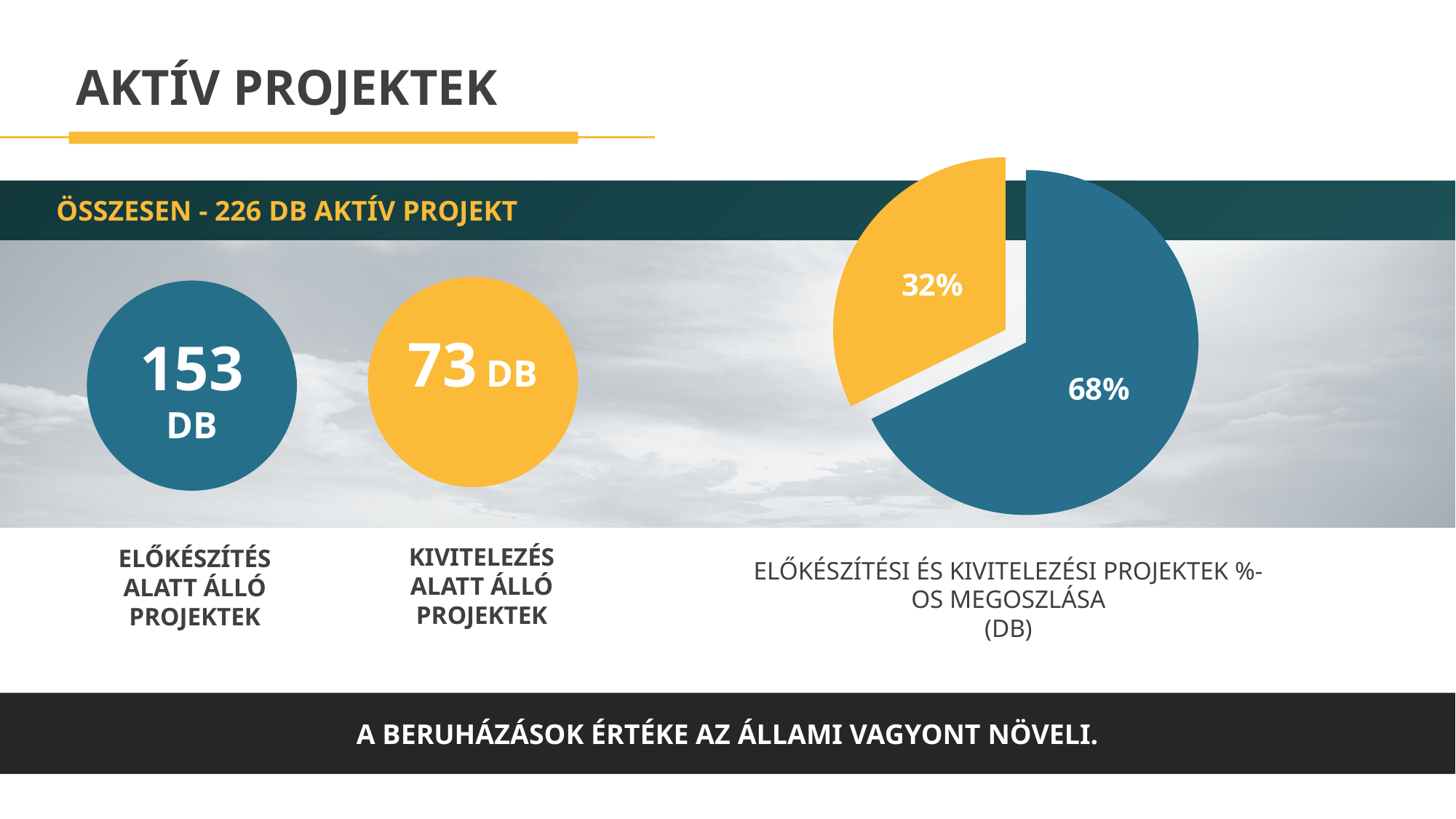
How many slices does the pie chart have? 2 What percentage is shown on the yellow slice of the pie chart? 32% What kind of chart is shown on the right side of the slide? pie chart Which slice of the pie chart is pulled out (exploded) from the rest? the yellow 32% slice By how many percentage points does the blue slice exceed the yellow slice in the pie chart? 36 percentage points What is the total number of active projects stated on the slide that the pie chart's shares are based on? 226 DB Which slice of the pie chart is the smallest? the yellow slice (32%) Is the blue slice or the yellow slice of the pie chart larger? the blue slice Is the share of the yellow slice in the pie chart greater or less than 50%? less What percentage is shown on the blue slice of the pie chart? 68% What is the title of the pie chart? ELŐKÉSZÍTÉSI ÉS KIVITELEZÉSI PROJEKTEK %-OS MEGOSZLÁSA (DB) Which slice of the pie chart is the largest? the blue slice (68%)